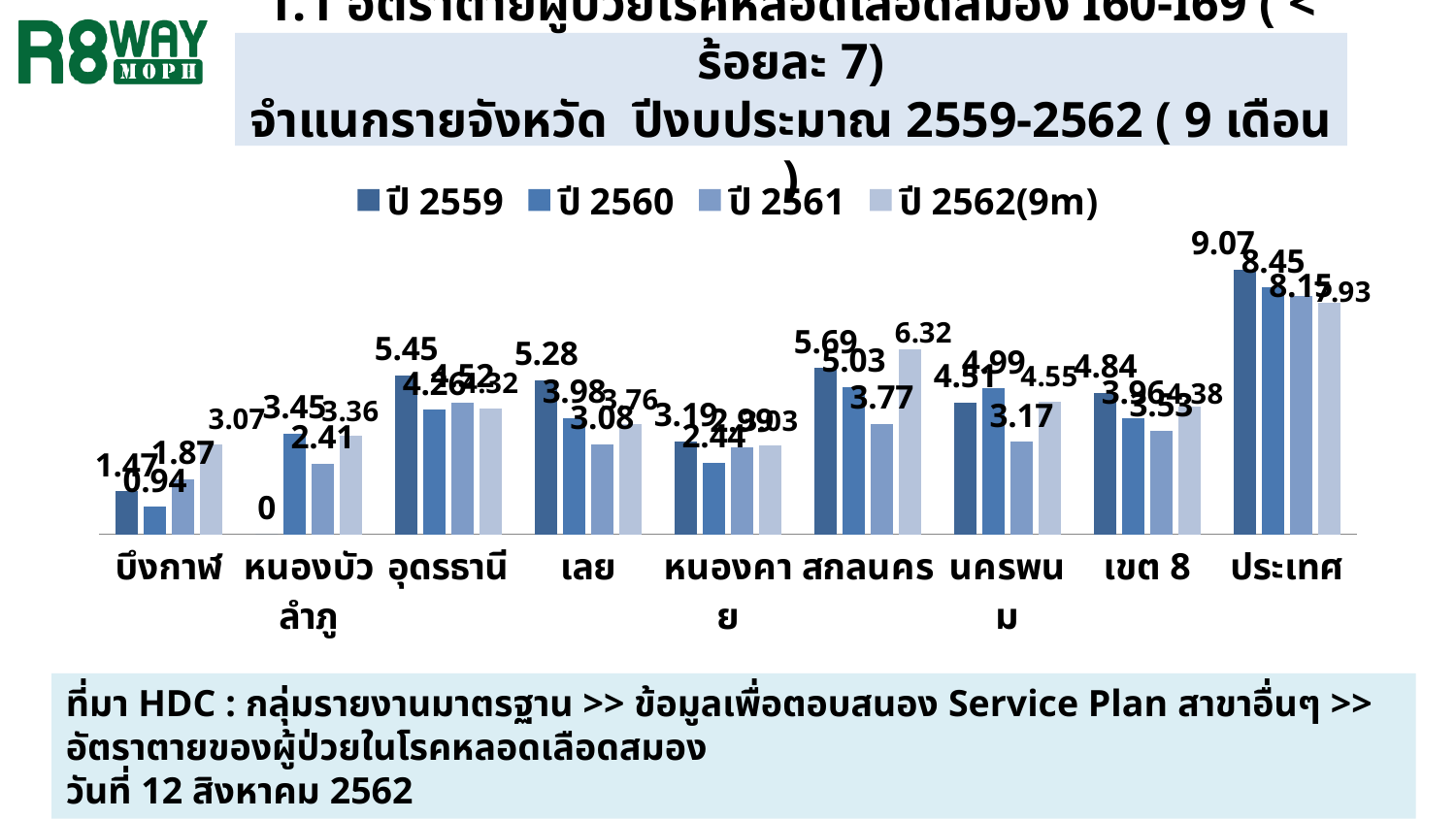
Which category has the highest value in the ปี 2559 series? ประเทศ What is the value for สกลนคร in the ปี 2562(9m) series? 6.32 Which category has the lowest value in the ปี 2560 series? บึงกาฬ How many series does the legend list? 4 What is the value for ประเทศ in the ปี 2559 series? 9.07 Do the values for ประเทศ rise or fall from ปี 2559 to ปี 2562(9m)? fall How many categories are shown on the x axis? 9 What is the value for หนองบัวลำภู in the ปี 2559 series? 0 What is the difference between the ปี 2559 and ปี 2562(9m) values for ประเทศ? 1.14 What is the value for บึงกาฬ in the ปี 2560 series? 0.94 What kind of chart is shown on the slide? bar chart Which is larger for สกลนคร: the ปี 2559 value or the ปี 2561 value? ปี 2559